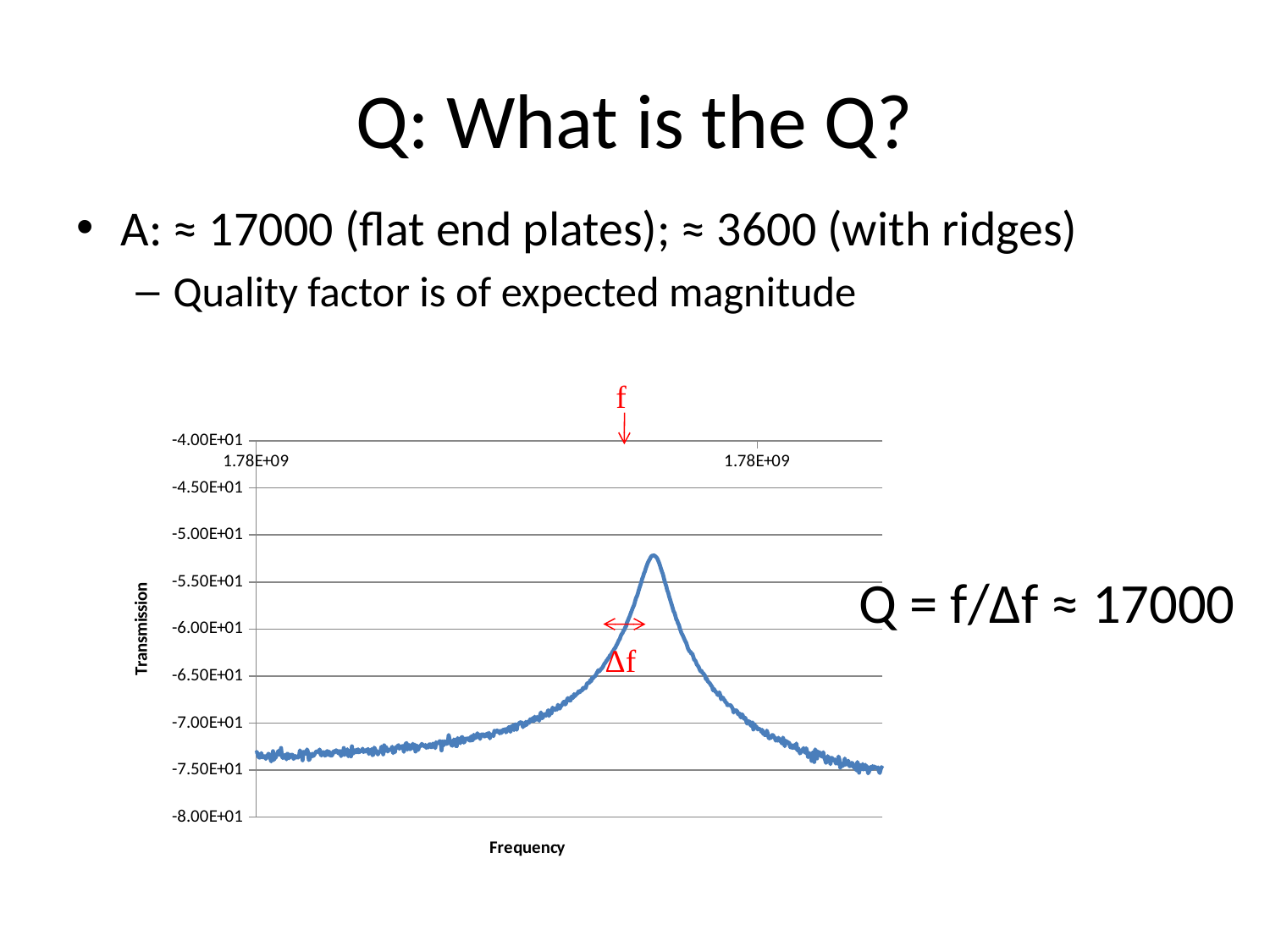
Which is larger: the transmission at the peak of the curve or the transmission at the left end of the curve? the peak Is the peak value of the transmission curve greater or less than -5.00E+01? less Is the transmission value at the left end of the curve greater or less than -7.00E+01? less Is the transmission value at the left end of the curve greater or less than -7.50E+01? greater What is the lowest tick value shown on the vertical axis? -8.00E+01 What is the title of the vertical axis of the chart? Transmission Does the transmission curve rise or fall as frequency increases from the left edge toward the peak? rise What is the title of the horizontal axis of the chart? Frequency What kind of chart is shown on the slide? line chart Does the transmission curve rise or fall as frequency increases from the peak toward the right edge? fall